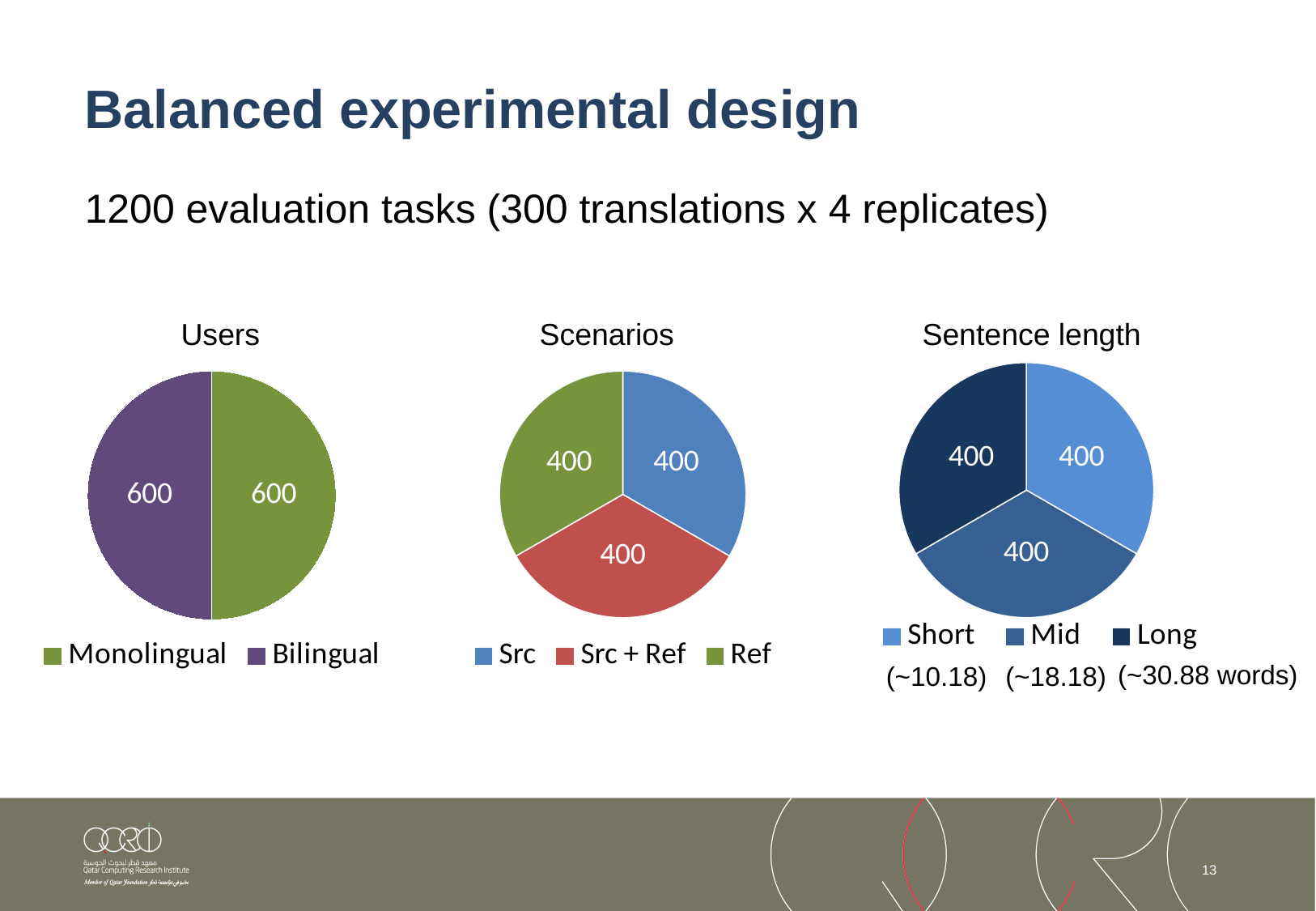
What is the total of all slices in the Sentence length chart? 1200 In the Users chart, what share of the total does the Bilingual slice represent? 50% In the Sentence length chart, what is the value for Long? 400 In the Users chart, what is the value for Monolingual? 600 How many slices does the Scenarios chart have? 3 In the Scenarios chart, what is the value for Src + Ref? 400 In the Users chart, what is the value for Bilingual? 600 What kind of chart is the Users chart? pie chart In the Scenarios chart, which colour is used for the Src + Ref slice? red How many entries does the legend of the Sentence length chart list? 3 In the Users chart, what is the difference between the Monolingual and Bilingual values? 0 In the Scenarios chart, what share of the total does the Ref slice represent? one third